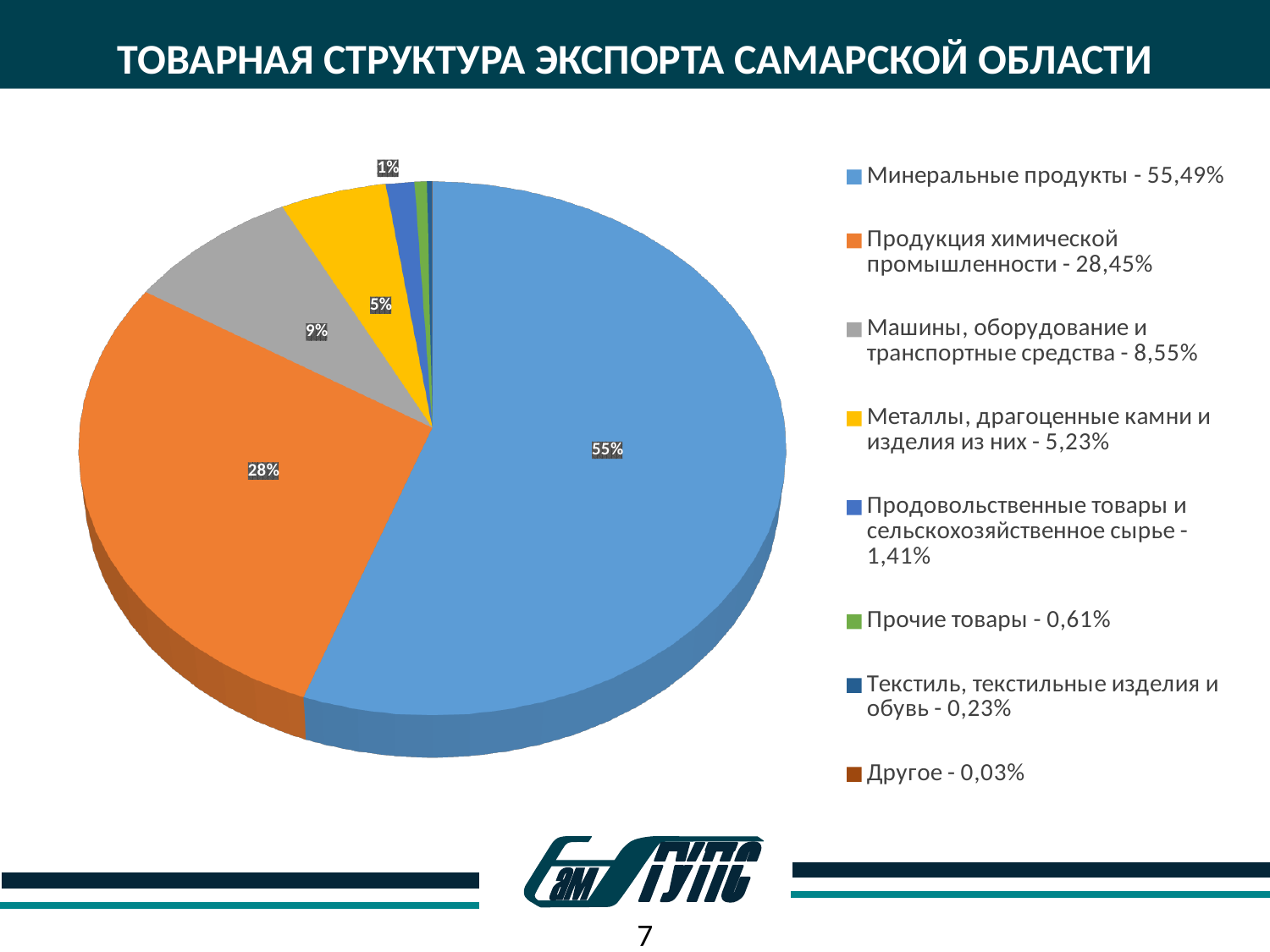
How many categories does the legend of the pie chart list? 8 What share is given in the legend for Прочие товары? 0,61% Which category has the largest share of the pie? Минеральные продукты What data label is printed on the slice for Машины, оборудование и транспортные средства? 9% What is the title of the slide containing the pie chart? ТОВАРНАЯ СТРУКТУРА ЭКСПОРТА САМАРСКОЙ ОБЛАСТИ By how many percentage points does the share of Минеральные продукты exceed that of Продукция химической промышленности, using the legend values? 27,04% What share is given in the legend for Минеральные продукты? 55,49% Which category has the smallest share of the pie? Другое What kind of chart is shown on the slide? pie chart Which has a larger share: Машины, оборудование и транспортные средства or Металлы, драгоценные камни и изделия из них? Машины, оборудование и транспортные средства What share is given in the legend for Продукция химической промышленности? 28,45% What colour is the slice for Продукция химической промышленности? orange